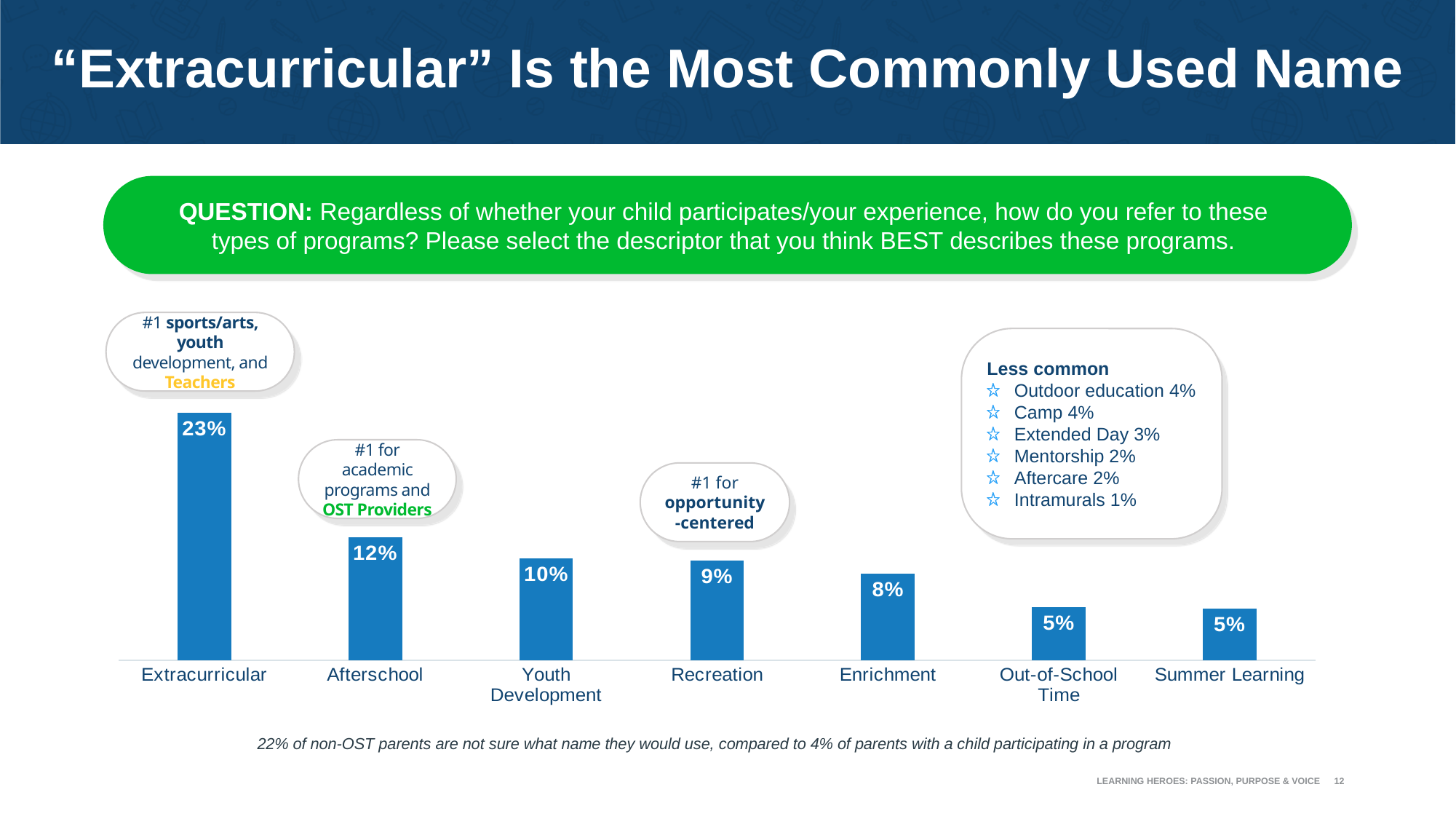
Which two categories share the lowest value of 5%? Out-of-School Time and Summer Learning Which category has the highest value in the chart? Extracurricular What is the difference between the values for "Extracurricular" and "Afterschool"? 11% What is the value shown for "Youth Development"? 10% What is the difference between the values for "Recreation" and "Enrichment"? 1% What kind of chart is shown on the slide? Bar chart Which is larger, the value for "Youth Development" or the value for "Recreation"? Youth Development Do the values rise or fall moving from left to right along the x axis? Fall What is the value shown for "Afterschool"? 12% How many categories are shown on the x axis of the chart? 7 What percentage of parents refer to these programs as "Extracurricular"? 23% What is the value shown for "Enrichment"? 8%